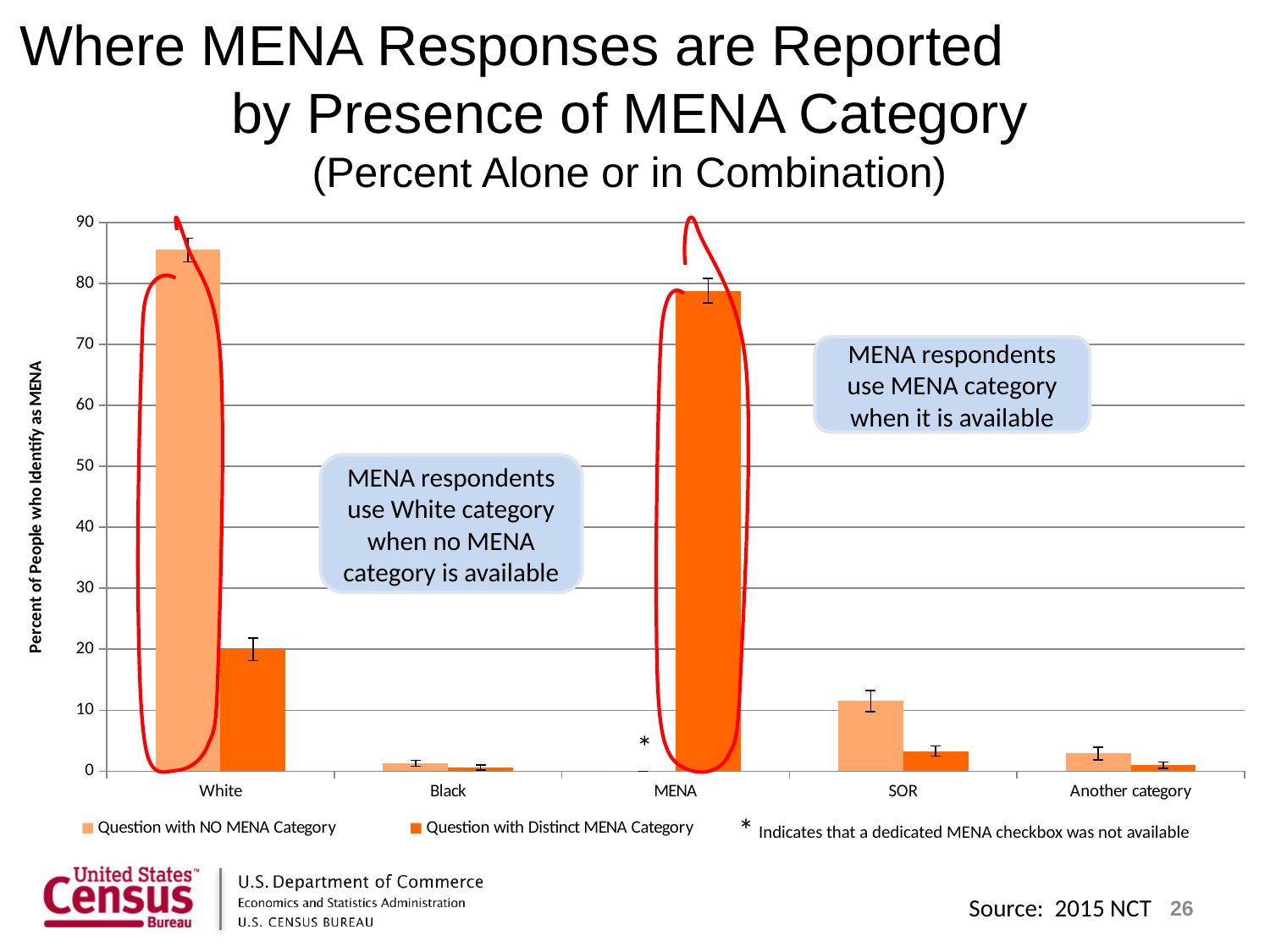
How many series does the chart's legend list? 2 Is the value for White in the 'Question with NO MENA Category' series greater or less than 80? greater Is the value for Black in the 'Question with NO MENA Category' series greater or less than 10? less Which is larger: the White bar for 'Question with NO MENA Category' or the MENA bar for 'Question with Distinct MENA Category'? White bar for Question with NO MENA Category Which category has the highest bar for the 'Question with NO MENA Category' series? White According to the footnote, what does the asterisk (*) on the chart indicate? A dedicated MENA checkbox was not available Which category has the highest bar for the 'Question with Distinct MENA Category' series? MENA How many categories are shown on the x axis of the chart? 5 Which is larger for the SOR category: the 'Question with NO MENA Category' bar or the 'Question with Distinct MENA Category' bar? Question with NO MENA Category Is the value for SOR in the 'Question with NO MENA Category' series greater or less than 20? less What kind of chart is shown on the slide? bar chart